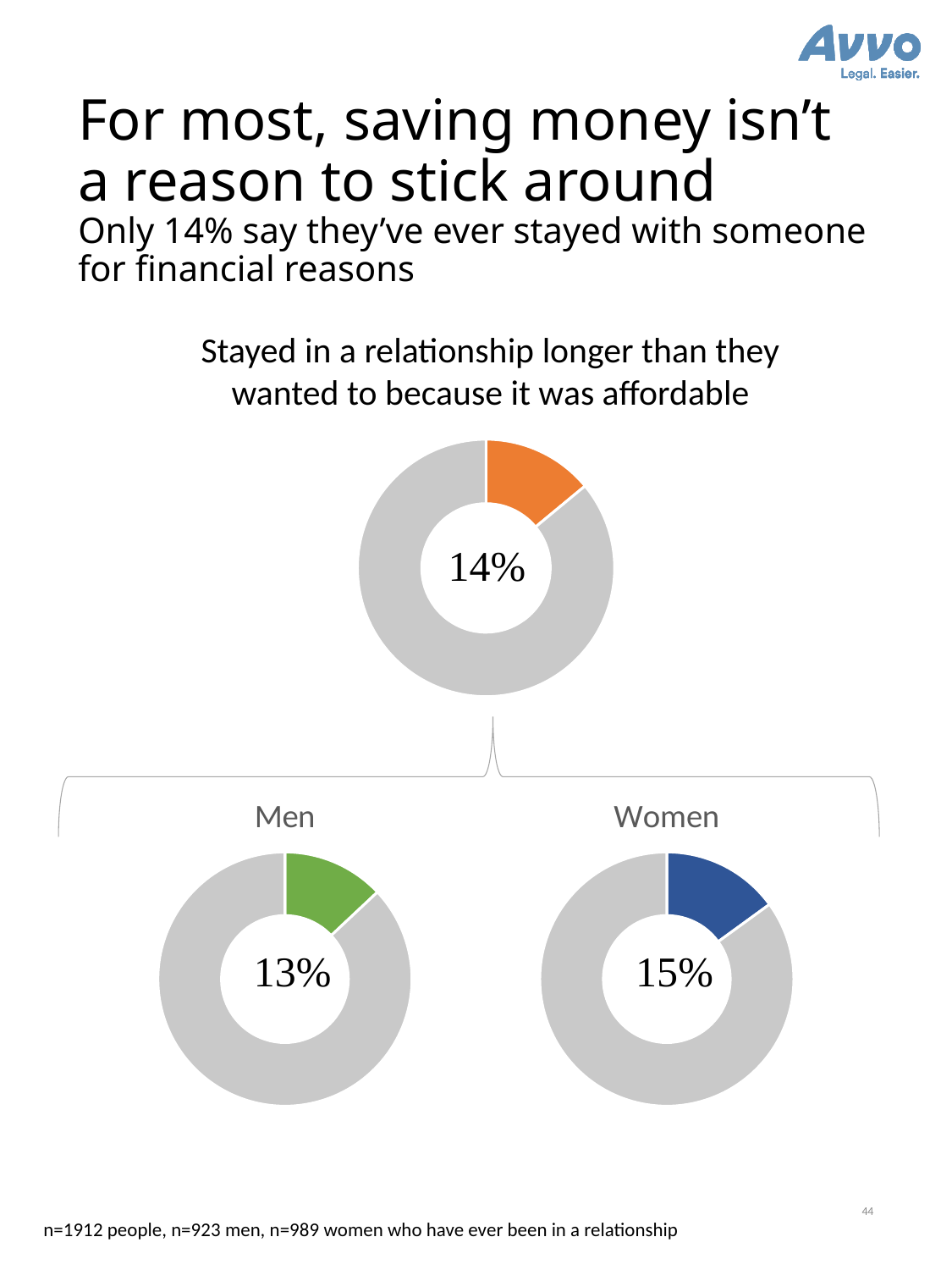
Is the percentage shown in the 'Men' donut chart greater or less than the percentage in the top overall donut chart? less What kind of chart is used to show the 14% figure at the top of the slide? Donut (pie) chart What colour is the highlighted segment in the 'Women' donut chart? Blue In the 'Women' donut chart at the bottom right, what percentage is shown? 15% In the top donut chart titled 'Stayed in a relationship longer than they wanted to because it was affordable', what percentage is shown in the centre? 14% In the 'Men' donut chart, what share of the ring is coloured green? 13% What is the difference between the percentage in the 'Women' chart and the percentage in the 'Men' chart? 2% In the 'Men' donut chart at the bottom left, what percentage is shown? 13% What is the title printed above the top donut chart? Stayed in a relationship longer than they wanted to because it was affordable How many donut charts are shown on the slide? 3 In the top donut chart, what share of the ring is coloured orange? 14% Comparing the 'Men' and 'Women' donut charts, which group has the higher percentage? Women